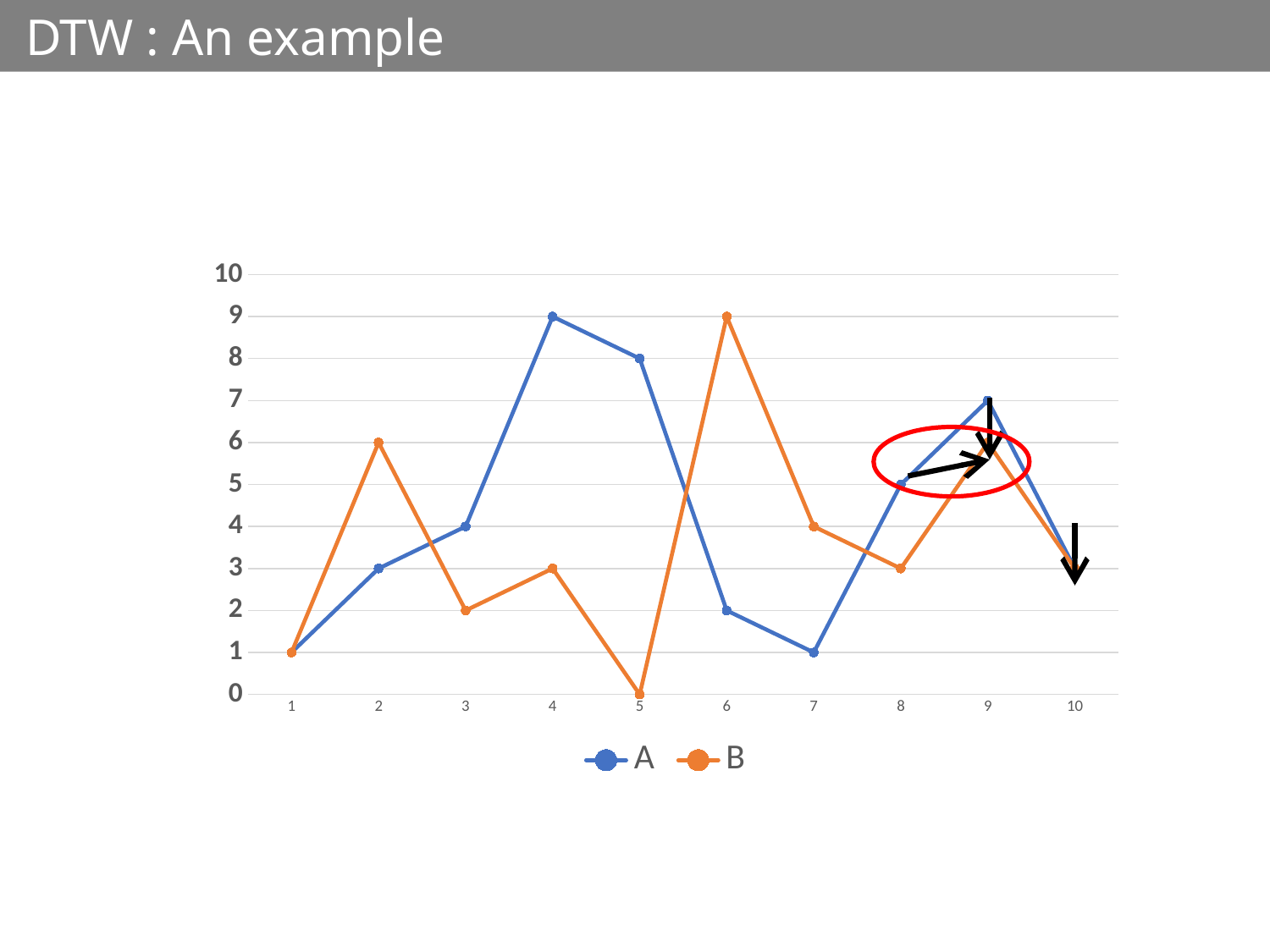
What is the difference between series A and series B at x = 7? 3 What is the value of series A at x = 4? 9 At x = 2, which series has the larger value, A or B? B Which series is drawn in orange? B How many series does the legend list? 2 Is the value of series A at x = 5 greater or less than 5? greater What is the value of series B at x = 6? 9 At which x value does series A reach its highest point? 4 What kind of chart is shown on the slide? line chart How many points are plotted along the x axis for each series? 10 At which x value does series B reach its lowest point? 5 What is the value of series B at x = 5? 0